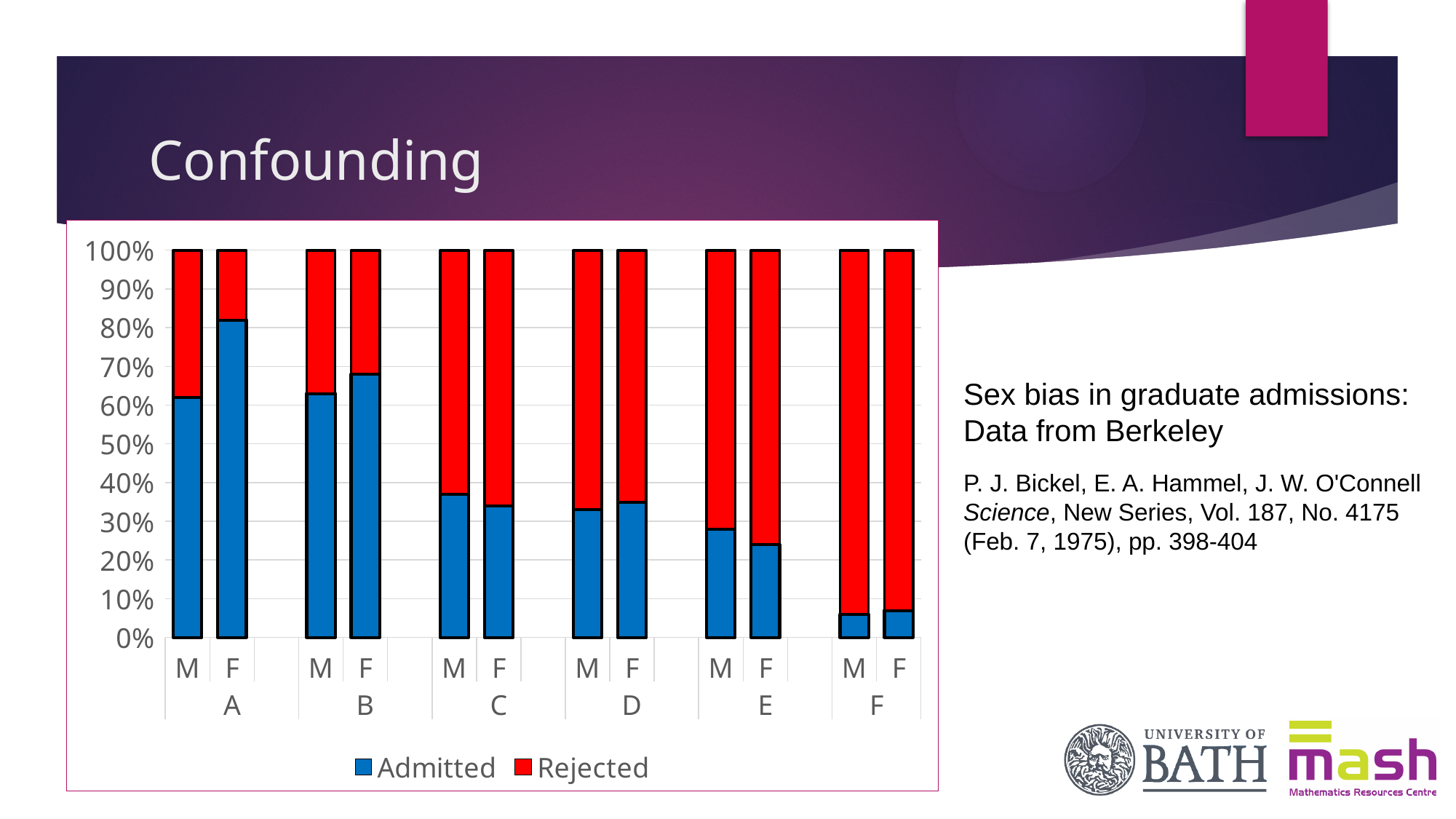
Is the Admitted share for F in department E greater or less than 30%? less Which bar has the highest Admitted share? F in department A How many series does the legend list? 2 What does each stacked bar total? 100% How many bars are plotted in the chart? 12 Is the Admitted share for M in department A greater or less than 50%? greater How many departments are shown along the x axis? 6 In department A, which has the larger Admitted share, M or F? F What kind of chart is shown on the slide? stacked bar chart Is the Admitted share for M in department F greater or less than 10%? less What are the two series named in the legend? Admitted and Rejected Which bar has the lowest Rejected share? F in department A